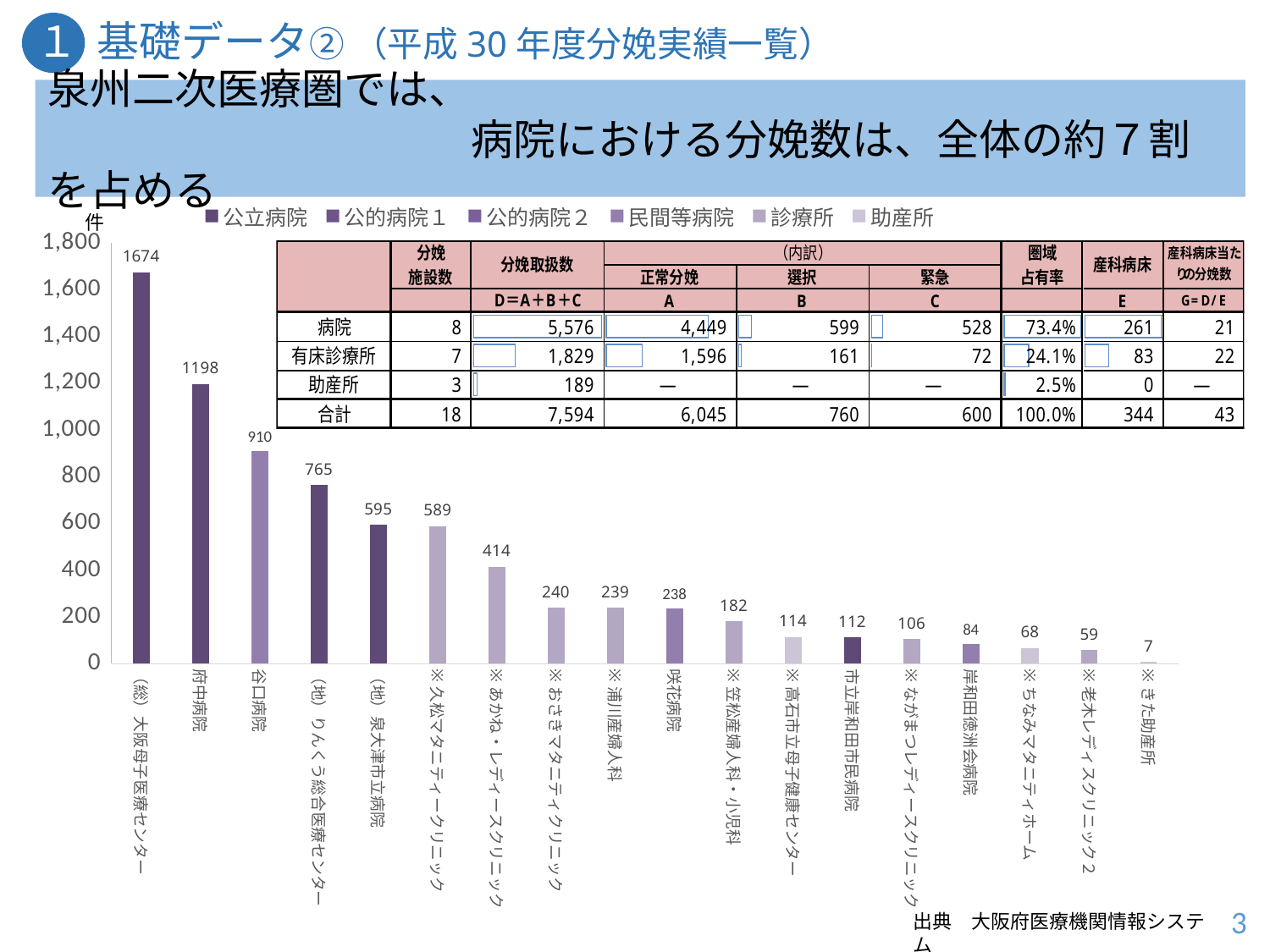
Do the values rise or fall from left to right along the x axis of the bar chart? fall Which is larger, the value for (地)りんくう総合医療センター or the value for (地)泉大津市立病院? (地)りんくう総合医療センター What is the value for ※あかね・レディースクリニック in the bar chart? 414 Which category has the lowest value in the bar chart? ※きた助産所 What kind of chart is shown on the slide? bar chart Which category has the highest value in the bar chart? (総)大阪母子医療センター What is the difference between the values for (総)大阪母子医療センター and 府中病院? 476 How many categories are shown on the x axis of the bar chart? 18 How many series does the legend of the bar chart list? 6 What is the value for 府中病院 in the bar chart? 1198 What is the value for 谷口病院 in the bar chart? 910 Is the value for 咲花病院 greater or less than 400? less